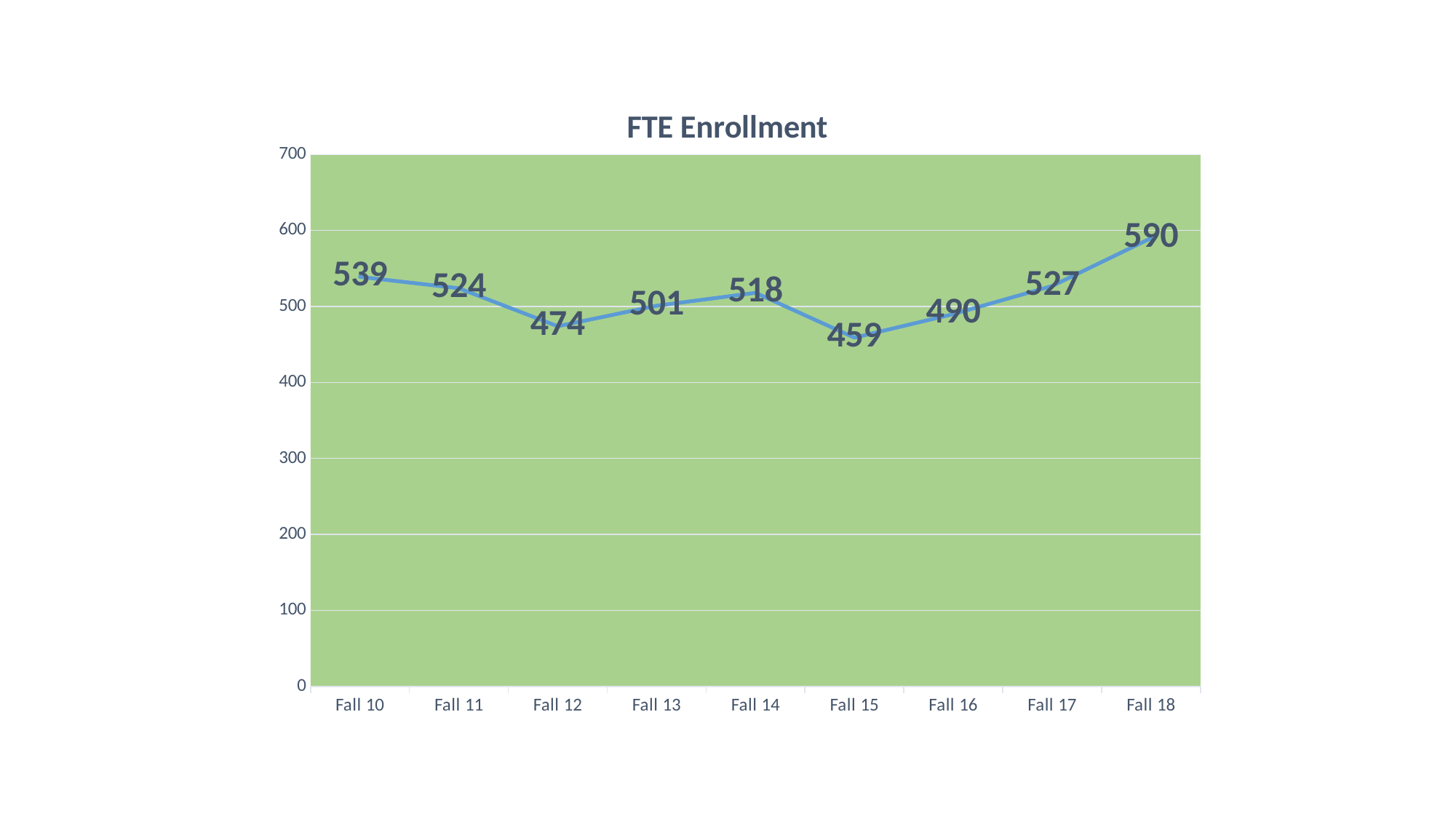
What is the FTE Enrollment value for Fall 14? 518 What is the FTE Enrollment value for Fall 17? 527 Does FTE Enrollment rise or fall from Fall 15 to Fall 18? rise Is the FTE Enrollment value for Fall 15 greater or less than 500? less Which has a higher FTE Enrollment, Fall 13 or Fall 16? Fall 13 What kind of chart is shown on the slide? line chart How many terms are plotted on the FTE Enrollment chart? 9 What is the difference in FTE Enrollment between Fall 18 and Fall 15? 131 What is the FTE Enrollment value for Fall 12? 474 Which term has the lowest FTE Enrollment? Fall 15 Which term has the highest FTE Enrollment? Fall 18 What is the difference in FTE Enrollment between Fall 10 and Fall 11? 15